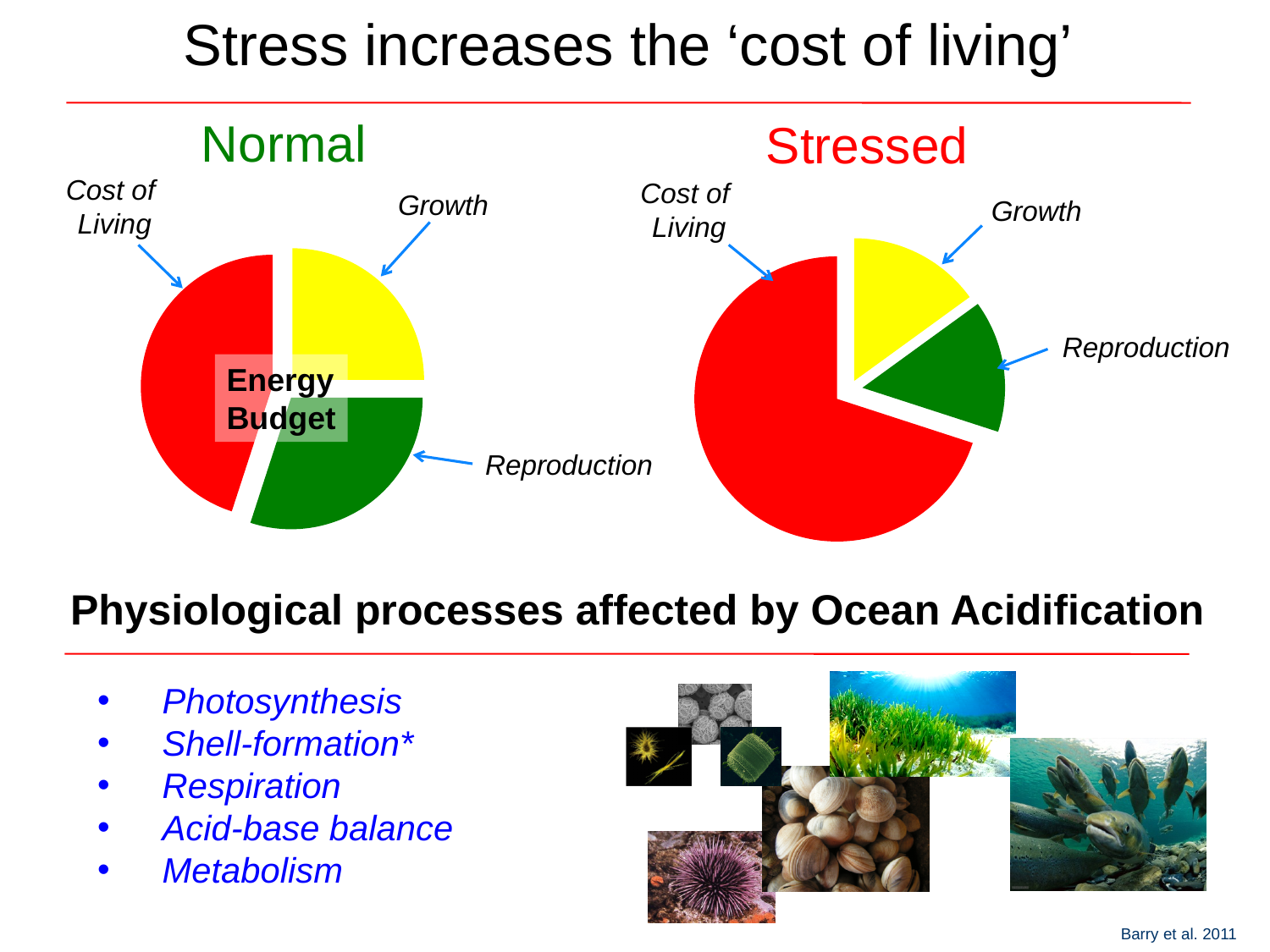
In the 'Normal' pie chart, what colour is the Reproduction slice? green In the 'Normal' pie chart, which slice is larger, Cost of Living or Reproduction? Cost of Living In the 'Normal' pie chart, how many slices are there? 3 In the 'Stressed' pie chart, which category has the largest slice? Cost of Living What kind of chart is the 'Normal' chart on the left? pie chart Which pie chart shows a larger Cost of Living slice, 'Normal' or 'Stressed'? Stressed Which pie chart shows a larger Growth slice, 'Normal' or 'Stressed'? Normal What kind of chart is the 'Stressed' chart on the right? pie chart In the 'Normal' pie chart, which category has the largest slice? Cost of Living In the 'Stressed' pie chart, how many slices are there? 3 What label is printed in the centre of the 'Normal' pie chart? Energy Budget